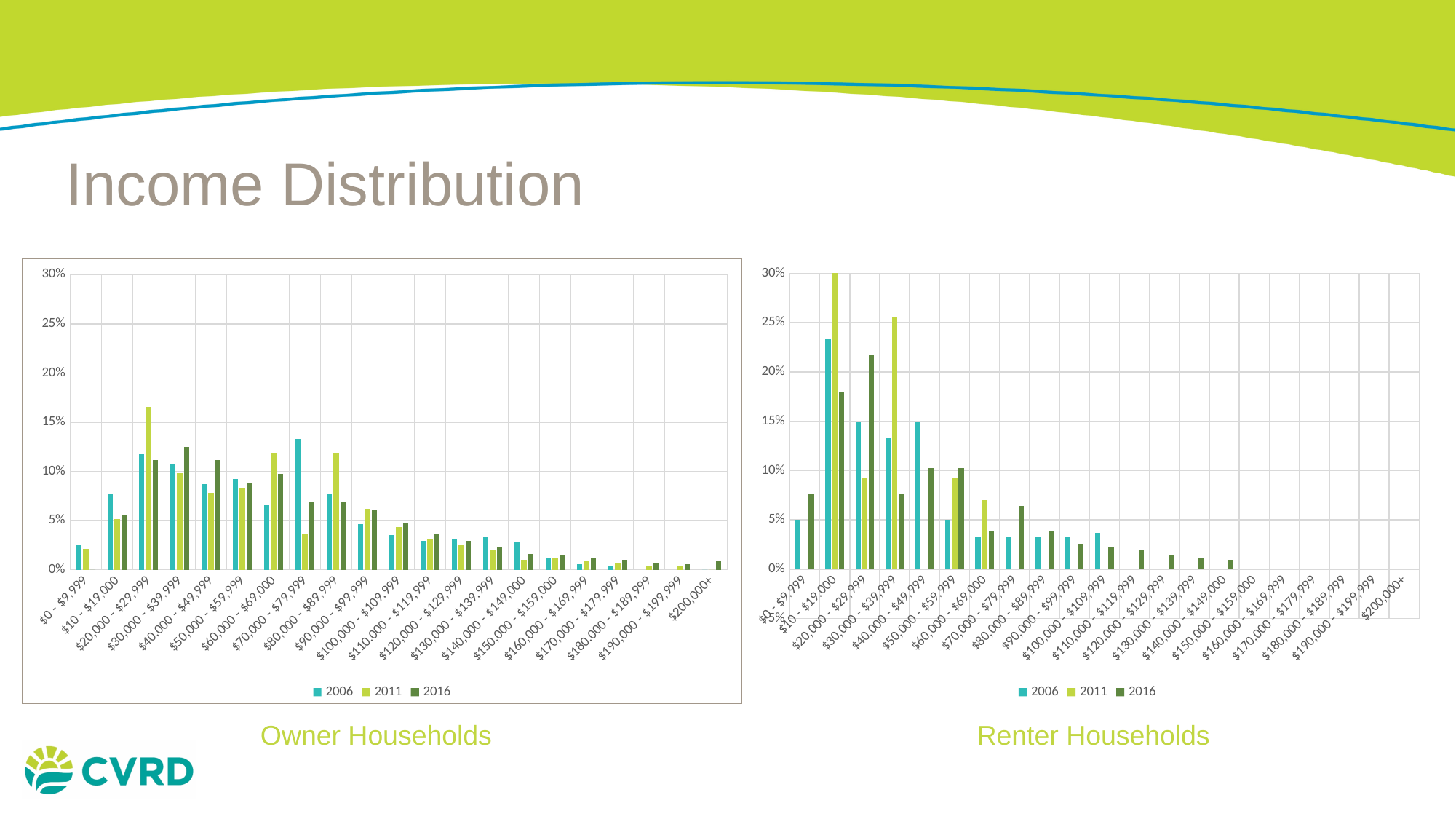
What kind of chart is the Owner Households chart? bar chart How many income categories are shown on the x axis of the Owner Households chart? 21 How many series does the legend of the Renter Households chart list? 3 In the Owner Households chart, is the 2011 value for $20,000 - $29,999 greater or less than 15%? greater In the Renter Households chart, for $10 - $19,000, which is larger: the 2006 value or the 2011 value? 2011 In the Owner Households chart, which income category has the highest 2011 value? $20,000 - $29,999 In the Owner Households chart, which income category has the highest 2006 value? $70,000 - $79,999 In the Renter Households chart, which income category has the highest 2016 value? $20,000 - $29,999 In the Renter Households chart, is the 2011 value for $30,000 - $39,999 greater or less than 25%? greater In the Owner Households chart, for $70,000 - $79,999, which is larger: the 2006 value or the 2011 value? 2006 In the Renter Households chart, is the 2016 value for $0 - $9,999 greater or less than 5%? greater